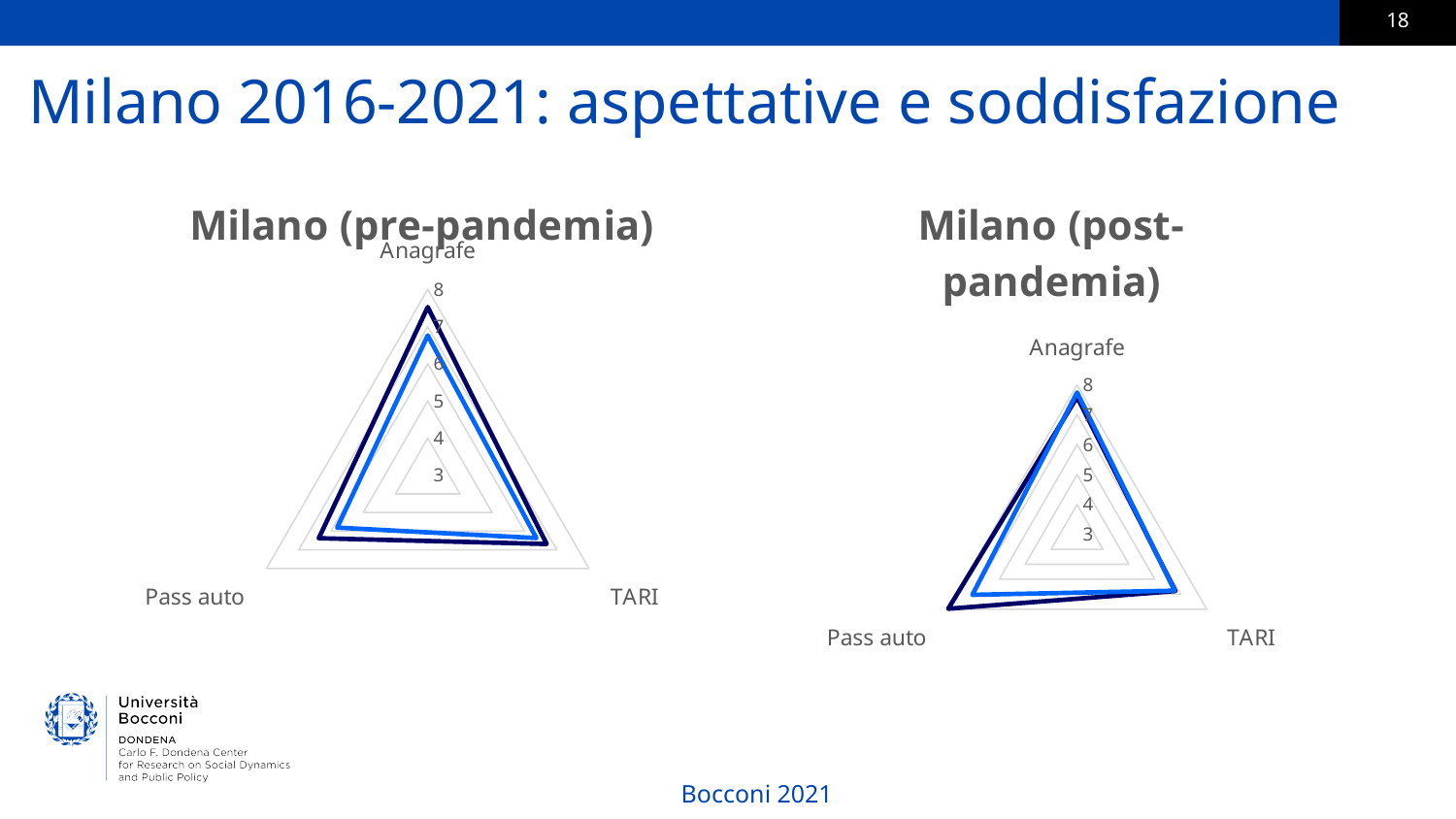
What kind of chart is the "Milano (post-pandemia)" chart? radar chart What are the three axis labels on the "Milano (post-pandemia)" radar chart? Anagrafe, Pass auto, TARI How many categories (axes) does the "Milano (pre-pandemia)" radar chart have? 3 What kind of chart is the "Milano (pre-pandemia)" chart? radar chart In the "Milano (post-pandemia)" chart, is the value of the light blue line for Pass auto greater or less than 5? greater In the "Milano (post-pandemia)" chart, is the value of the dark navy line for Anagrafe greater or less than 6? greater In the "Milano (post-pandemia)" chart, which line has the larger value for Pass auto, the dark navy line or the light blue line? the dark navy line In the "Milano (pre-pandemia)" chart, is the value of the light blue line for TARI greater or less than 5? greater How many categories (axes) does the "Milano (post-pandemia)" radar chart have? 3 What is the highest tick value shown on the axis scale of the "Milano (pre-pandemia)" radar chart? 8 In the "Milano (pre-pandemia)" chart, which line has the larger value for Anagrafe, the dark navy line or the light blue line? the dark navy line